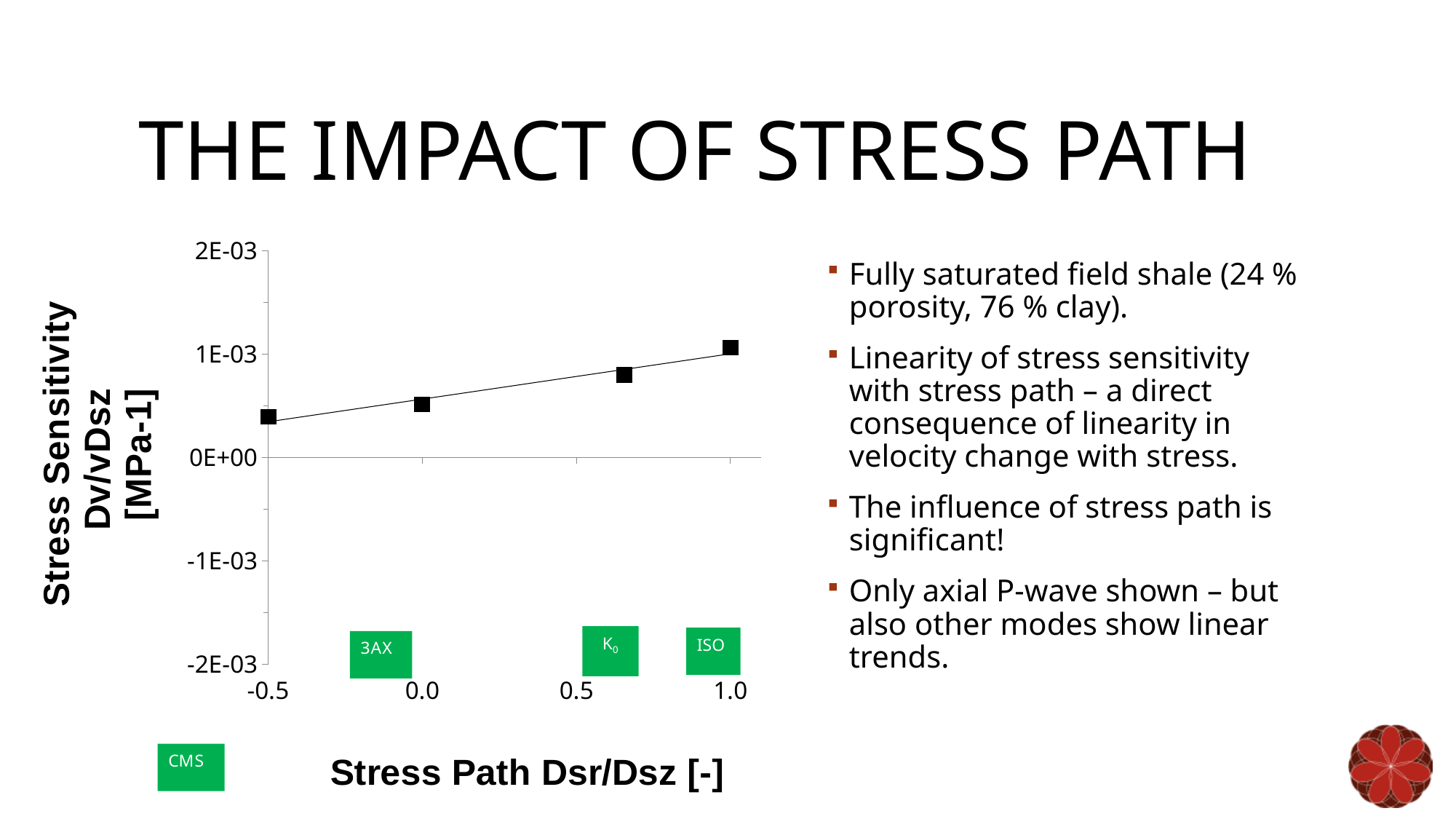
At which stress path value is the plotted stress sensitivity lowest? -0.5 At which stress path value is the plotted stress sensitivity highest? 1.0 Is the stress sensitivity at stress path -0.5 greater or less than 1E-03? less Which has the larger stress sensitivity: the point at stress path 1.0 or the point at stress path -0.5? 1.0 What is the title of the y axis of the chart? Stress Sensitivity Dv/vDsz [MPa-1] Is the stress sensitivity at stress path 1.0 greater or less than 2E-03? less What is the title of the x axis of the chart? Stress Path Dsr/Dsz [-] Is the stress sensitivity at stress path 0.0 greater or less than 0E+00? greater How many data points are plotted on the chart? 4 What kind of chart is shown on the slide? scatter plot Do the plotted stress sensitivity values rise or fall as the stress path Dsr/Dsz increases? rise